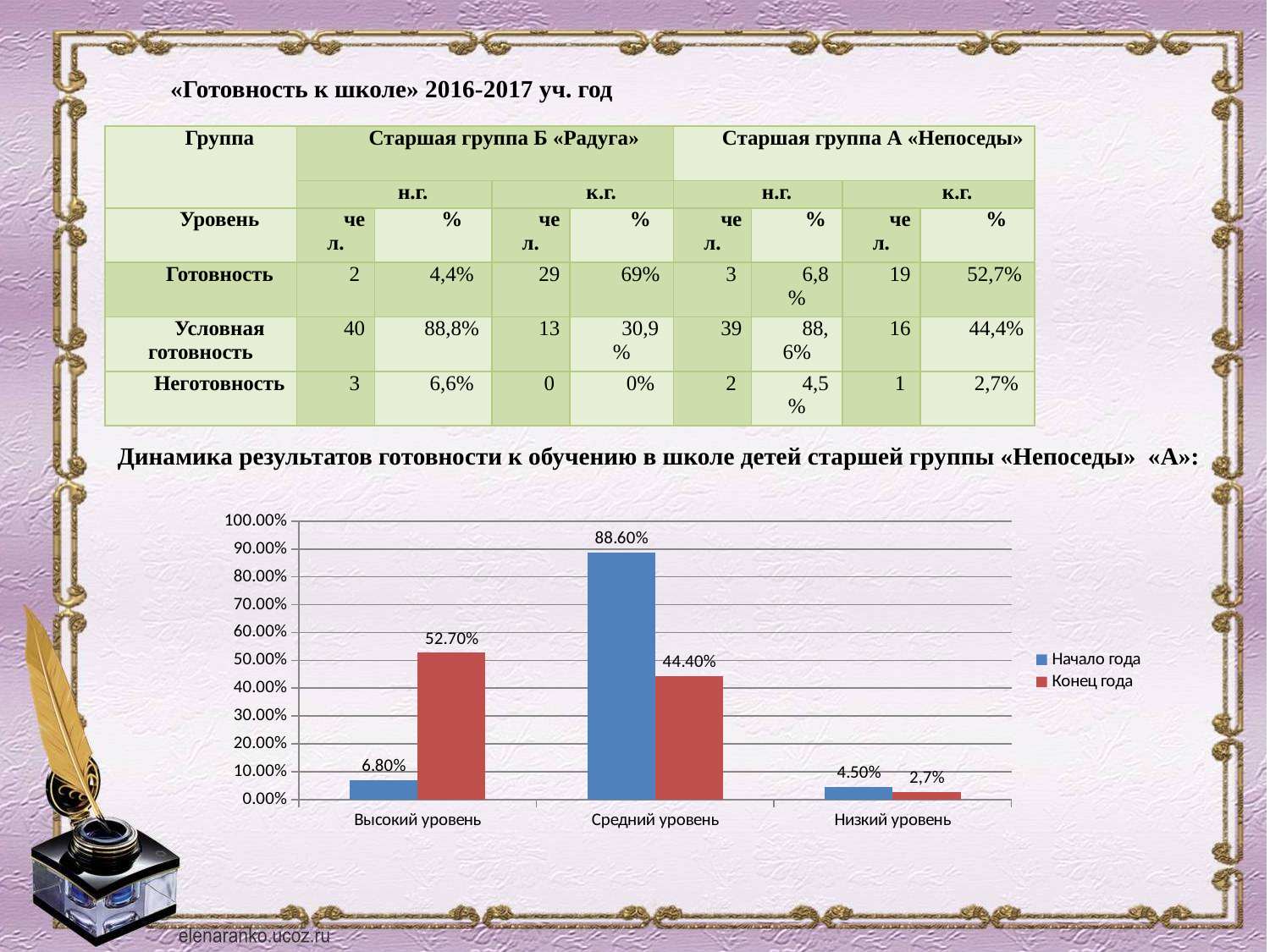
At Высокий уровень, which is larger: Начало года or Конец года? Конец года Which series is shown in red in the chart? Конец года What is the value for Начало года at Высокий уровень? 6.80% How many series does the chart legend list? 2 What is the value for Конец года at Высокий уровень? 52.70% Which category has the highest value for Начало года? Средний уровень What is the difference between Начало года and Конец года at Средний уровень? 44.20% What kind of chart is shown on the slide? bar chart What is the value for Конец года at Низкий уровень? 2,7% Which category has the lowest value for Конец года? Низкий уровень How many categories are shown on the x axis of the chart? 3 What is the value for Начало года at Средний уровень? 88.60%